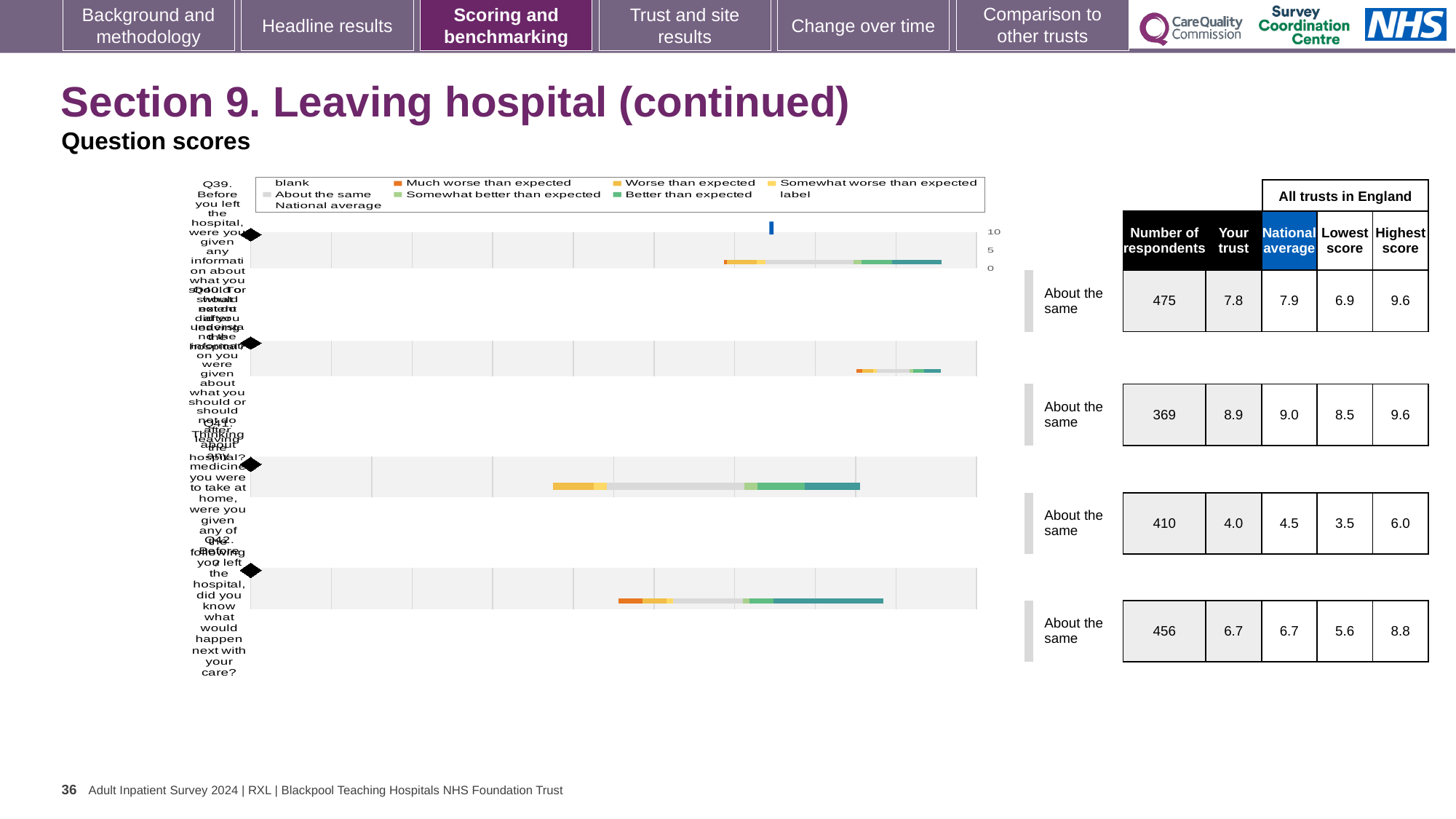
What kind of chart is shown on the slide? bar chart How many question rows (bars) are plotted in the chart? 4 Which colour does the legend use for 'Much worse than expected'? orange What is the highest value shown on the chart's axis? 10 What benchmark label is shown next to the Q42 bar? About the same What benchmark label is shown next to the Q39 bar? About the same